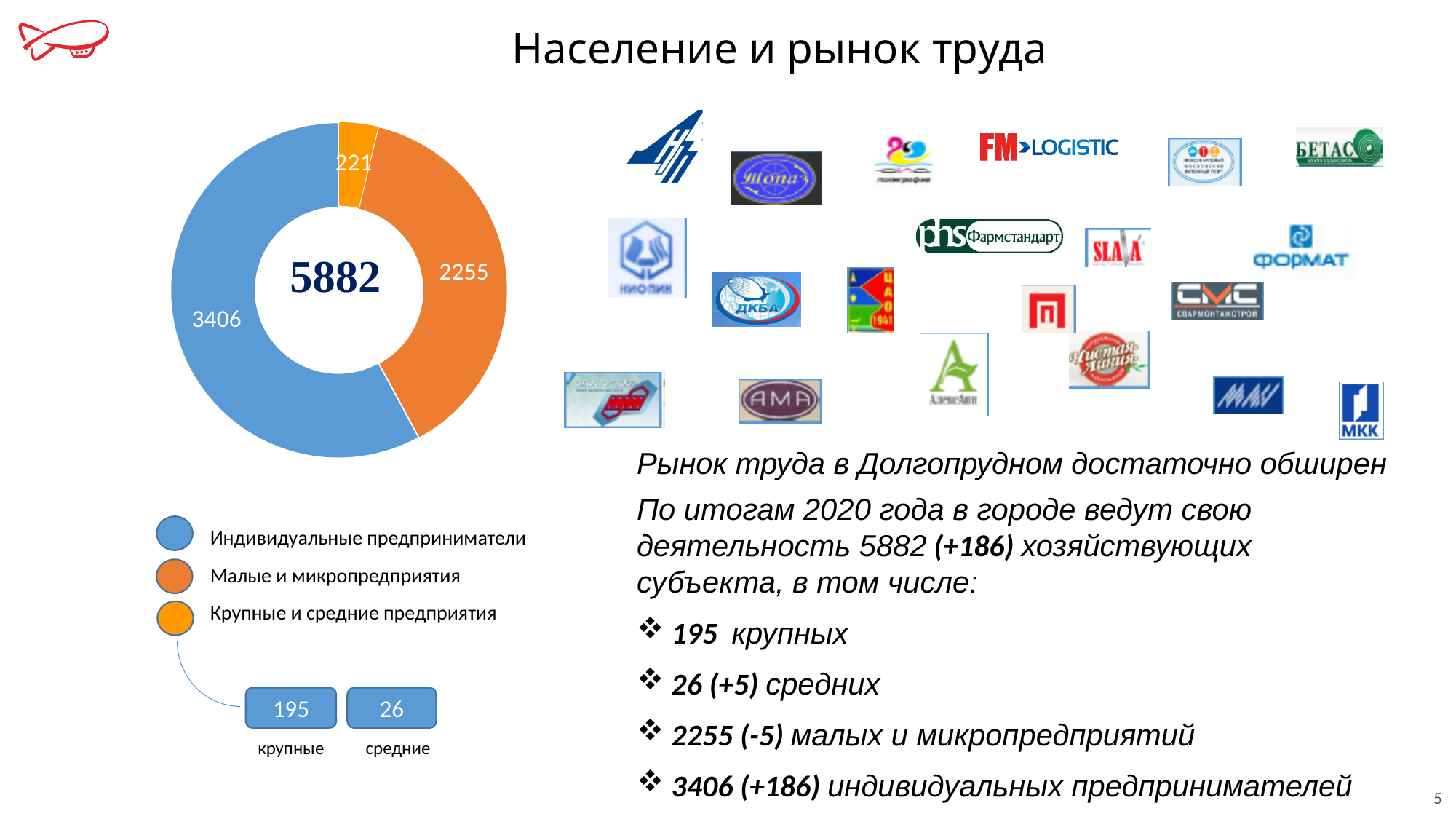
Which category has the largest segment in the doughnut chart? Индивидуальные предприниматели What total number is shown in the centre of the doughnut chart? 5882 What is the difference between the values for Малые и микропредприятия and Крупные и средние предприятия? 2034 Which category has the smallest segment in the doughnut chart? Крупные и средние предприятия How many categories does the doughnut chart show? 3 Which is larger: the value for Малые и микропредприятия or the value for Крупные и средние предприятия? Малые и микропредприятия What colour is the segment for Малые и микропредприятия? orange What type of chart is shown on the slide? doughnut chart What is the value for Крупные и средние предприятия in the doughnut chart? 221 What is the difference between the values for Индивидуальные предприниматели and Малые и микропредприятия? 1151 What is the value for Индивидуальные предприниматели in the doughnut chart? 3406 What is the value for Малые и микропредприятия in the doughnut chart? 2255